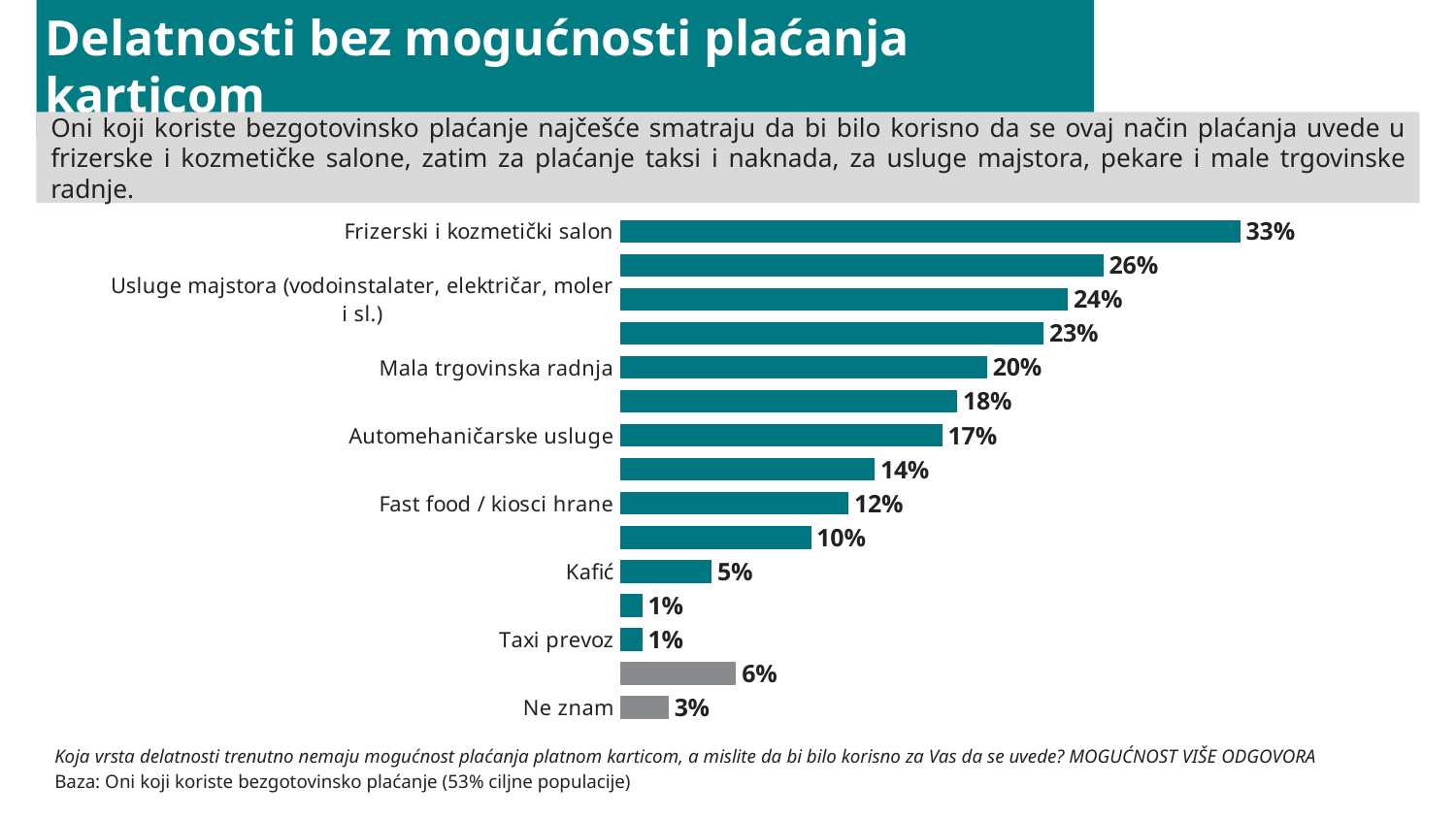
What is the value for Kafić? 5% Which category has the highest value? Frizerski i kozmetički salon What kind of chart is shown on the slide? Bar chart Which is larger, Kafić or Ne znam? Kafić What is the value for Fast food / kiosci hrane? 12% How many bars are plotted in the chart? 15 What is the difference between Frizerski i kozmetički salon and Ne znam? 30 percentage points What is the highest value shown in the chart? 33% What is the value for Frizerski i kozmetički salon? 33% What is the value for Automehaničarske usluge? 17% What is the value for Mala trgovinska radnja? 20% What is the value for Ne znam? 3%